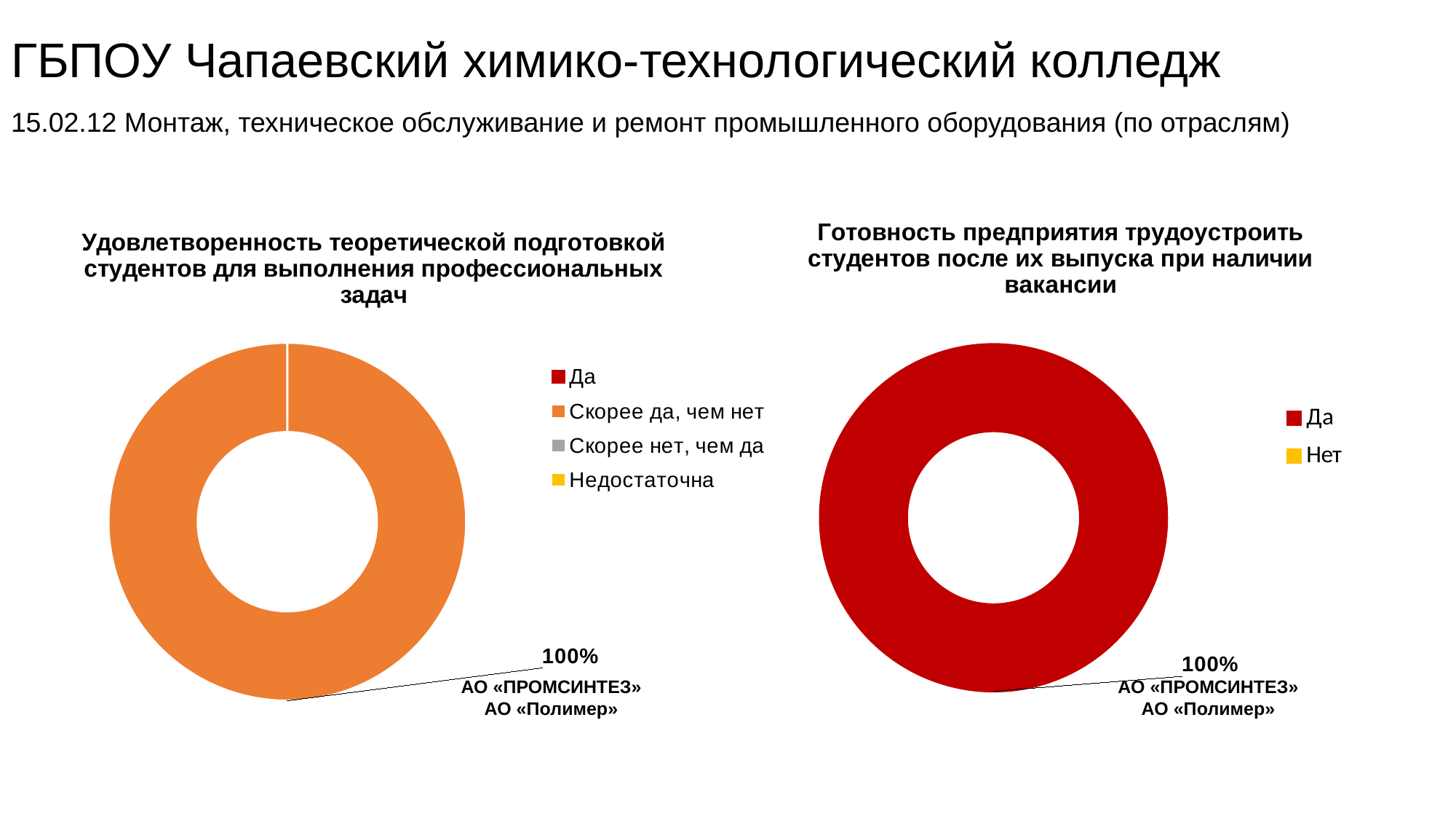
In the right chart («Готовность предприятия трудоустроить...»), which two companies are named in the data label? АО «ПРОМСИНТЕЗ» and АО «Полимер» In the right chart («Готовность предприятия трудоустроить...»), what value is printed on the data label? 100% What kind of chart is the left chart titled «Удовлетворенность теоретической подготовкой студентов для выполнения профессиональных задач»? Doughnut (pie) chart In the right chart («Готовность предприятия трудоустроить...»), how many entries does the legend list? 2 In the left chart («Удовлетворенность теоретической подготовкой...»), what share of the ring does the «Скорее да, чем нет» slice take? 100% In the right chart («Готовность предприятия трудоустроить...»), which legend category makes up the entire ring? Да In the left chart («Удовлетворенность теоретической подготовкой...»), what value is printed on the data label? 100% In the left chart («Удовлетворенность теоретической подготовкой...»), which legend category makes up the entire ring? Скорее да, чем нет In the right chart («Готовность предприятия трудоустроить...»), what share of the ring does the «Да» slice take? 100% What kind of chart is the right chart titled «Готовность предприятия трудоустроить студентов после их выпуска при наличии вакансии»? Doughnut (pie) chart In the left chart («Удовлетворенность теоретической подготовкой...»), how many entries does the legend list? 4 In the left chart («Удовлетворенность теоретической подготовкой...»), what colour is the «Скорее да, чем нет» legend entry? Orange